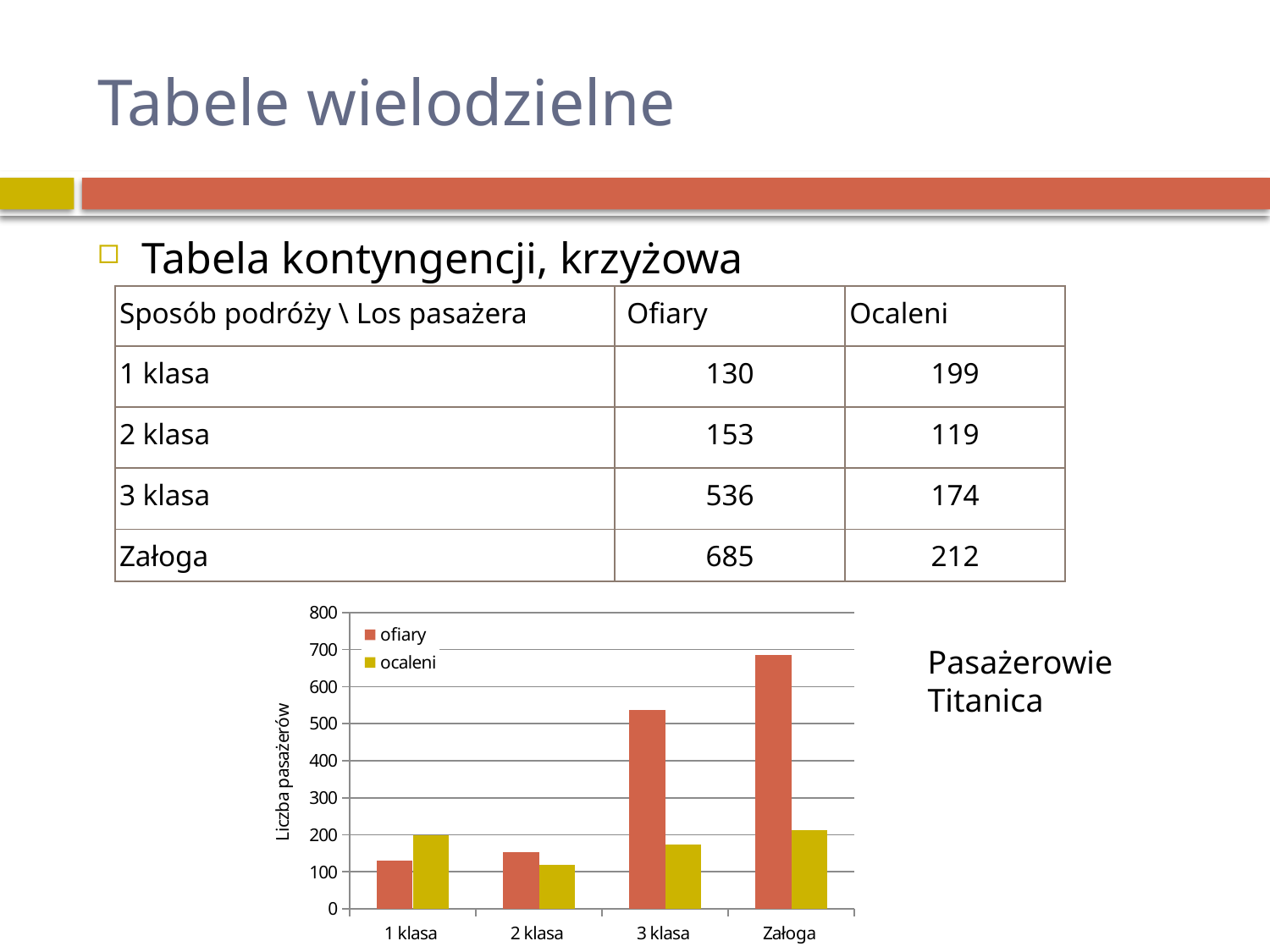
Which category has the highest value for the 'ofiary' series? Załoga According to the table on the slide, what is the 'Ocaleni' value for 3 klasa? 174 For 1 klasa, which is larger: 'ofiary' or 'ocaleni'? ocaleni According to the table on the slide, what is the 'Ofiary' value for Załoga? 685 How many series does the chart legend list? 2 Is the 'ocaleni' value for Załoga greater or less than 300? less What is the label of the chart's vertical axis? Liczba pasażerów Which category has the lowest value for the 'ocaleni' series? 2 klasa Using the table values, what is the difference between 'Ofiary' and 'Ocaleni' for 2 klasa? 34 How many categories are shown on the x axis of the chart? 4 What type of chart is shown on the slide? bar chart Is the 'ofiary' value for 3 klasa greater or less than 500? greater